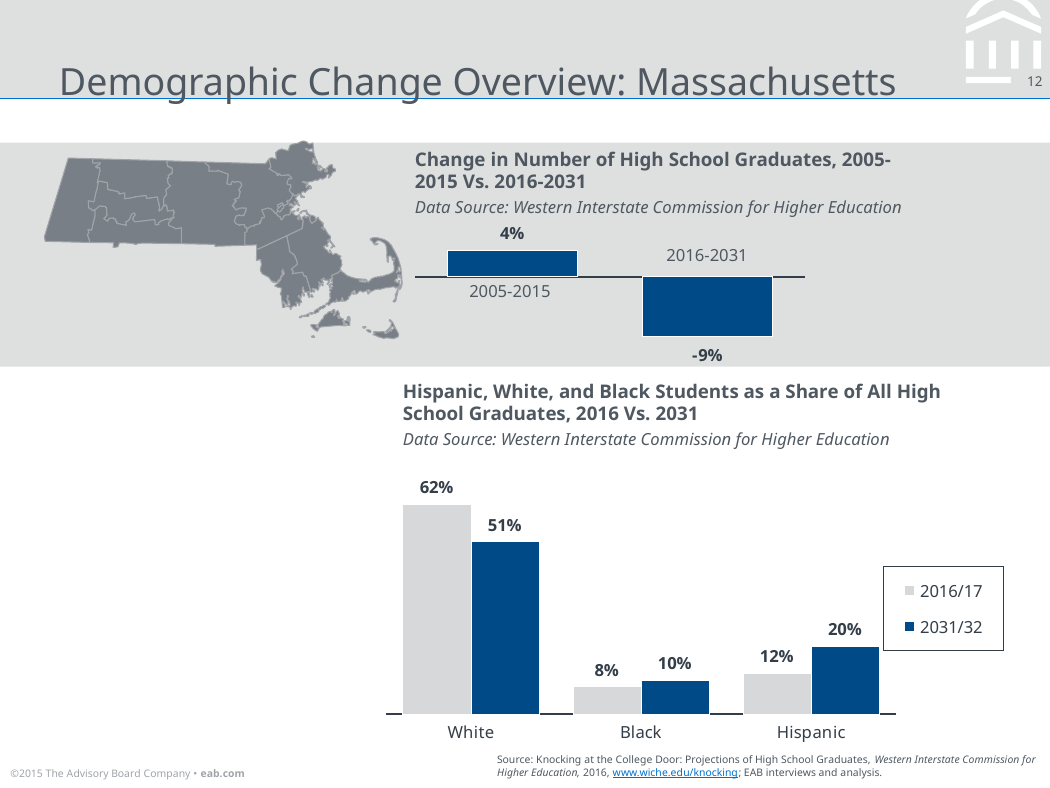
In the 'Share of All High School Graduates' chart, what is the 2016/17 value for White students? 62% In the 'Change in Number of High School Graduates' chart, which period has the higher value, 2005-2015 or 2016-2031? 2005-2015 In the 'Share of All High School Graduates' chart, which series is shown in dark blue? 2031/32 In the 'Share of All High School Graduates' chart, what is the 2016/17 value for Black students? 8% In the 'Change in Number of High School Graduates' chart, what is the value for 2005-2015? 4% In the 'Share of All High School Graduates' chart, what is the difference between the 2016/17 and 2031/32 values for White students? 11% What kind of chart is the 'Share of All High School Graduates' chart? Bar chart In the 'Share of All High School Graduates' chart, what is the 2031/32 value for Hispanic students? 20% In the 'Change in Number of High School Graduates' chart, how many categories are plotted? 2 In the 'Share of All High School Graduates' chart, which group has the lowest 2031/32 value? Black In the 'Share of All High School Graduates' chart, how many series does the legend list? 2 In the 'Change in Number of High School Graduates' chart, what is the value for 2016-2031? -9%